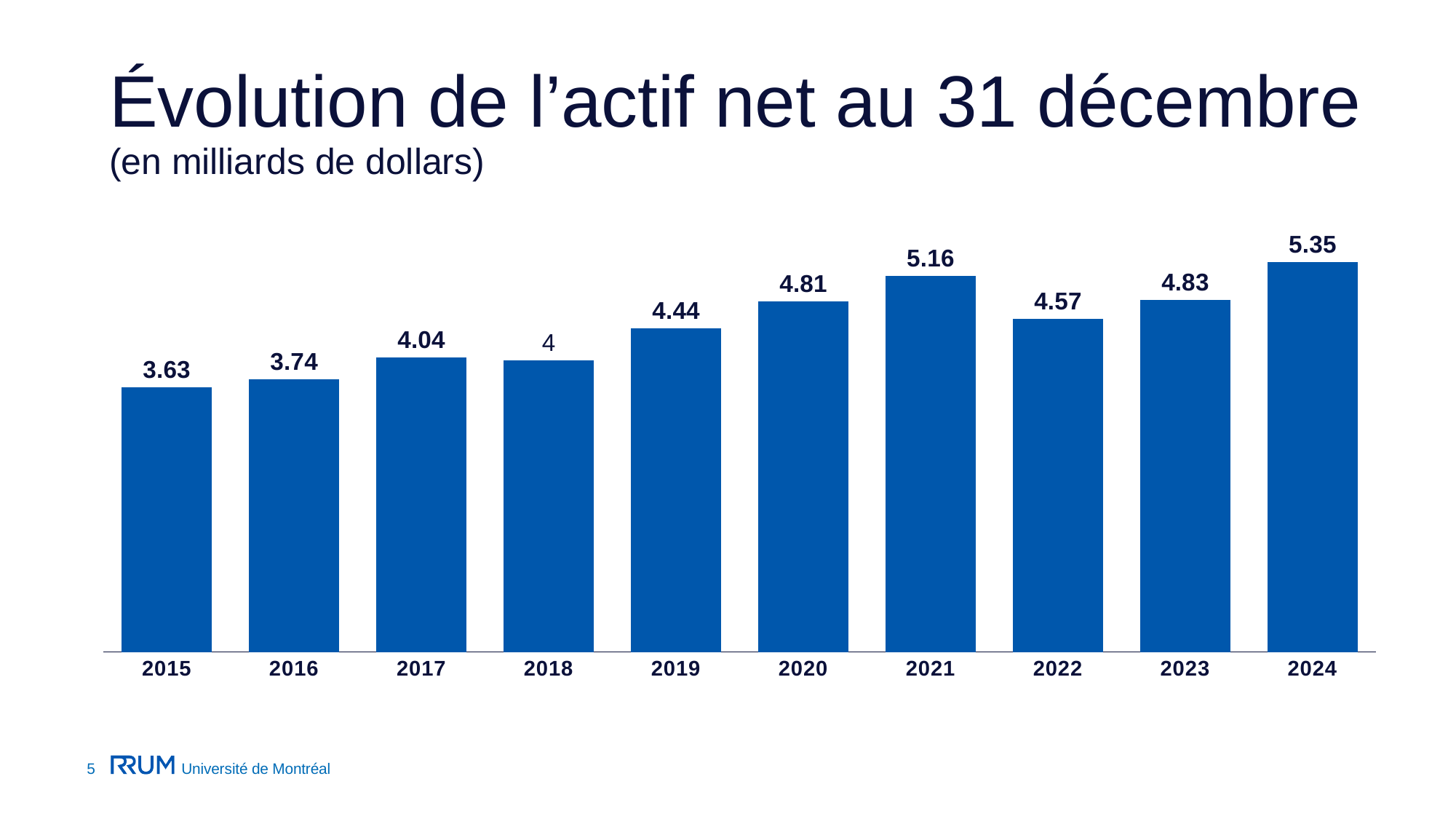
What kind of chart is shown on the slide? Bar chart Which year has the lowest value? 2015 What is the value for 2018? 4 How many years are shown on the x axis? 10 What is the value for 2021? 5.16 What is the value for 2015? 3.63 Do the values generally rise or fall from 2015 to 2024? Rise What is the difference between the values for 2021 and 2022? 0.59 Which year has the highest value? 2024 What is the difference between the values for 2024 and 2015? 1.72 Which is larger, the value for 2020 or the value for 2023? 2023 In what unit are the values expressed, according to the subtitle? En milliards de dollars